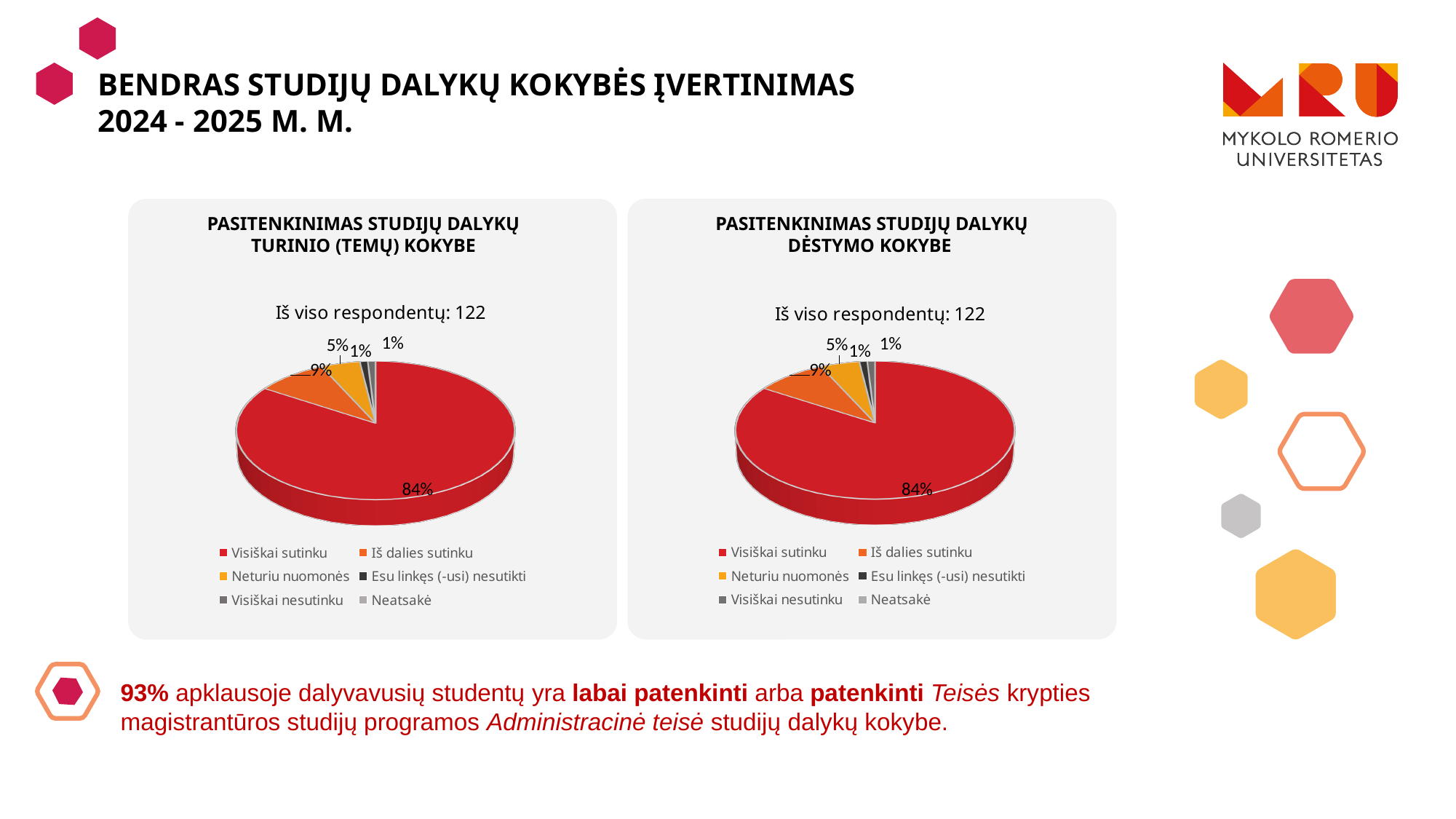
In the right chart (Pasitenkinimas studijų dalykų dėstymo kokybe), what share is labelled for 'Iš dalies sutinku'? 9% In the right chart (Pasitenkinimas studijų dalykų dėstymo kokybe), what colour is the 'Visiškai sutinku' slice? red How many respondents does the left chart (Pasitenkinimas studijų dalykų turinio (temų) kokybe) report in total? 122 In the left chart (Pasitenkinimas studijų dalykų turinio (temų) kokybe), what is the difference between the 'Visiškai sutinku' and 'Iš dalies sutinku' shares? 75% In the left chart (Pasitenkinimas studijų dalykų turinio (temų) kokybe), what share is labelled for 'Visiškai sutinku'? 84% In the left chart (Pasitenkinimas studijų dalykų turinio (temų) kokybe), which category has the largest slice? Visiškai sutinku What kind of chart is used in the 'Pasitenkinimas studijų dalykų turinio (temų) kokybe' panel? pie chart In the right chart (Pasitenkinimas studijų dalykų dėstymo kokybe), what is the combined share of 'Visiškai sutinku' and 'Iš dalies sutinku'? 93% In the left chart (Pasitenkinimas studijų dalykų turinio (temų) kokybe), what share is labelled for 'Neturiu nuomonės'? 5% In the right chart (Pasitenkinimas studijų dalykų dėstymo kokybe), which is larger: 'Iš dalies sutinku' or 'Neturiu nuomonės'? Iš dalies sutinku How many entries does the legend of the right chart (Pasitenkinimas studijų dalykų dėstymo kokybe) list? 6